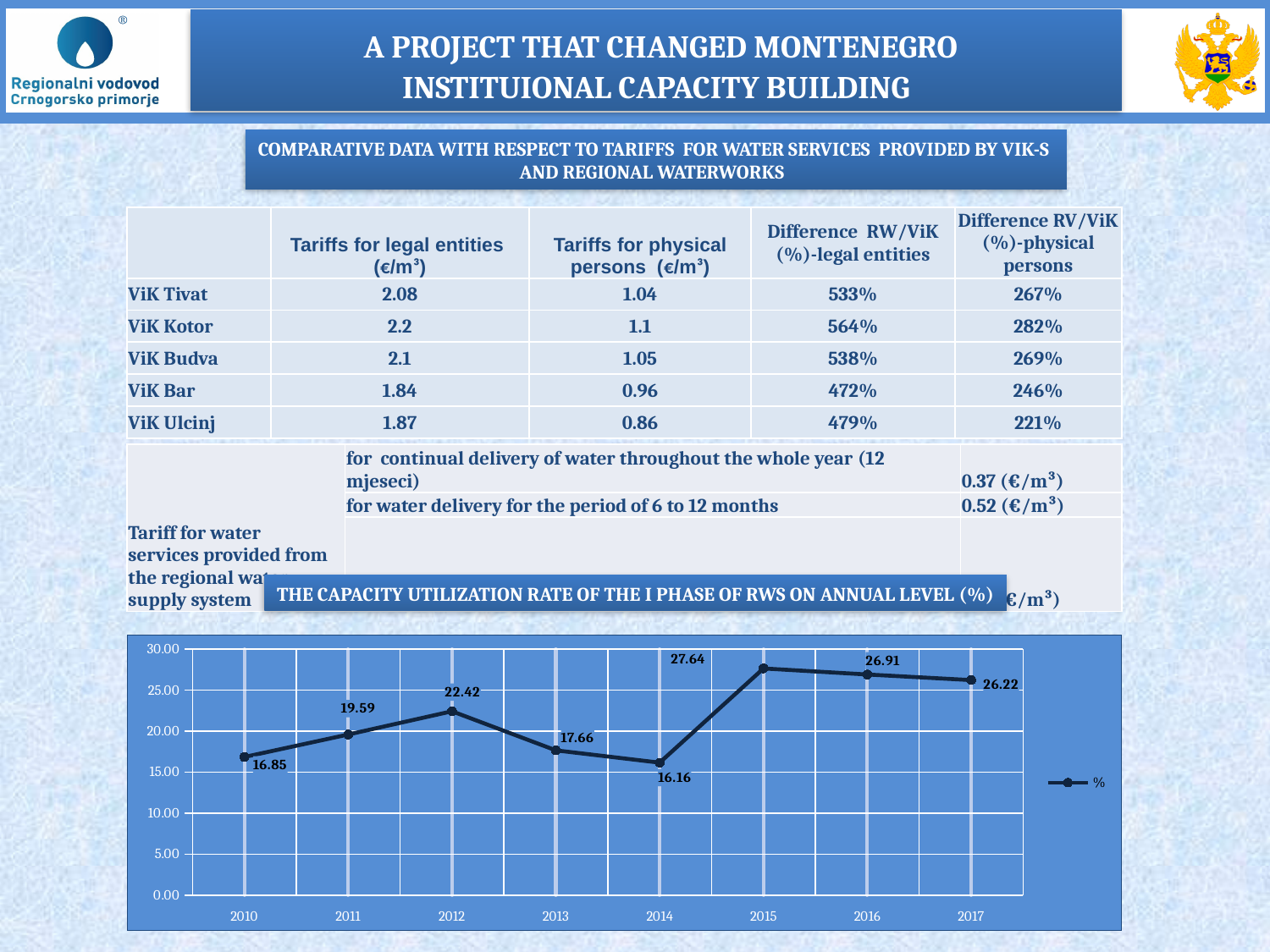
Does the value rise or fall from 2012 to 2014? fall What value does the line chart show for 2015? 27.64 What is the value plotted for 2013? 17.66 What is the difference between the values for 2015 and 2014? 11.48 Which is larger, the value for 2016 or the value for 2017? 2016 What is the difference between the values for 2012 and 2011? 2.83 How many years are plotted on the chart? 8 What kind of chart is shown at the bottom of the slide? line chart Which year has the highest capacity utilization rate on the chart? 2015 Which year has the lowest value on the chart? 2014 Is the value for 2012 greater or less than 20.00? greater What is the capacity utilization rate shown for 2010? 16.85